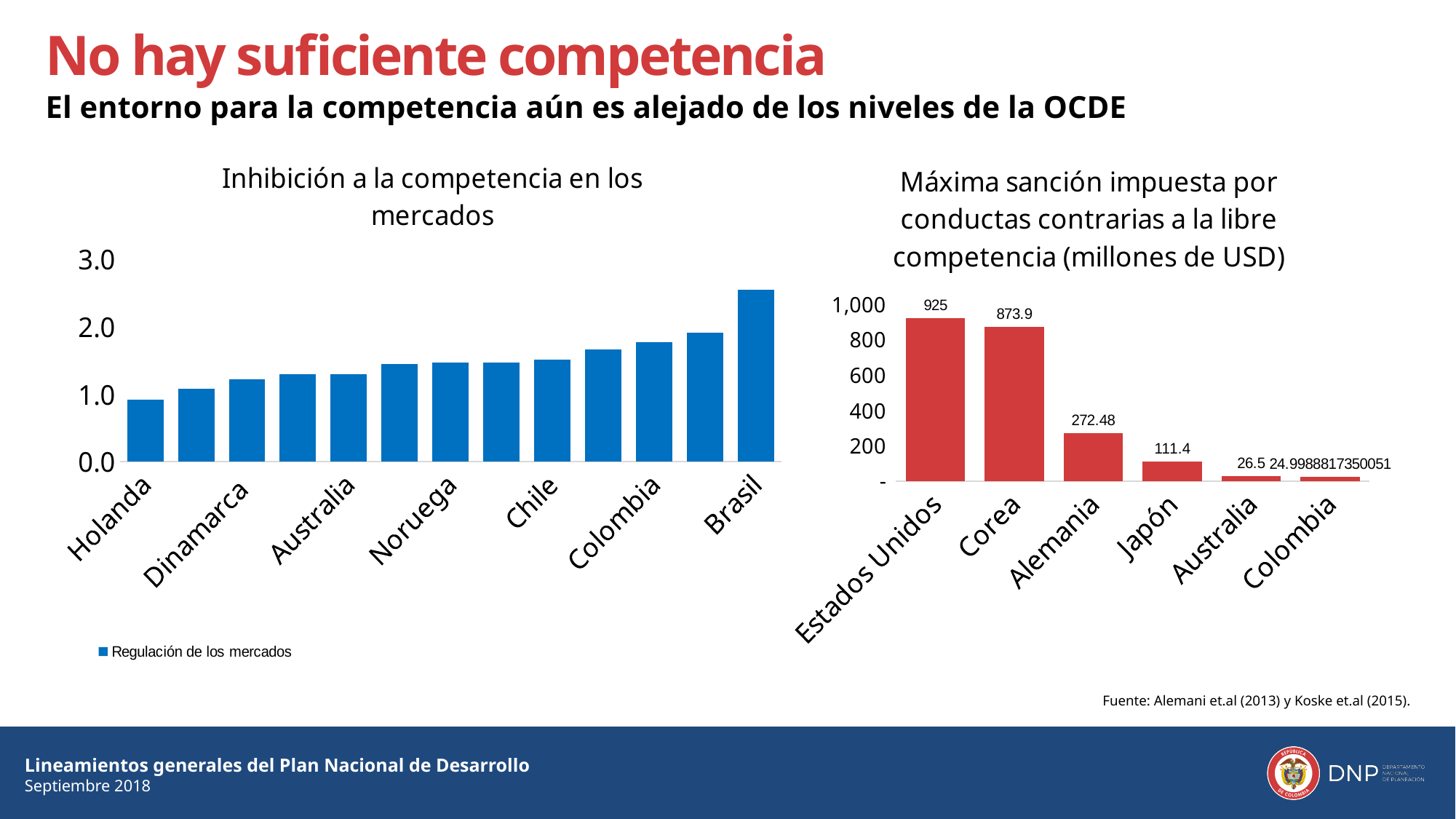
In the chart 'Máxima sanción impuesta por conductas contrarias a la libre competencia (millones de USD)', which country has the lowest value? Colombia What series name does the legend of the chart 'Inhibición a la competencia en los mercados' show? Regulación de los mercados In the chart 'Máxima sanción impuesta por conductas contrarias a la libre competencia (millones de USD)', which is larger, the value for Alemania or the value for Japón? Alemania In the chart 'Inhibición a la competencia en los mercados', which labelled country has the highest bar? Brasil In the chart 'Máxima sanción impuesta por conductas contrarias a la libre competencia (millones de USD)', what is the difference between the values for Estados Unidos and Corea? 51.1 In the chart 'Inhibición a la competencia en los mercados', do the values rise or fall from left to right along the x axis? rise In the chart 'Máxima sanción impuesta por conductas contrarias a la libre competencia (millones de USD)', how many countries are shown? 6 In the chart 'Máxima sanción impuesta por conductas contrarias a la libre competencia (millones de USD)', what is the value for Estados Unidos? 925 In the chart 'Máxima sanción impuesta por conductas contrarias a la libre competencia (millones de USD)', what is the value for Japón? 111.4 In the chart 'Inhibición a la competencia en los mercados', is the value for Brasil greater or less than 2.0? greater In the chart 'Máxima sanción impuesta por conductas contrarias a la libre competencia (millones de USD)', what is the value for Alemania? 272.48 In the chart 'Máxima sanción impuesta por conductas contrarias a la libre competencia (millones de USD)', which country has the highest value? Estados Unidos